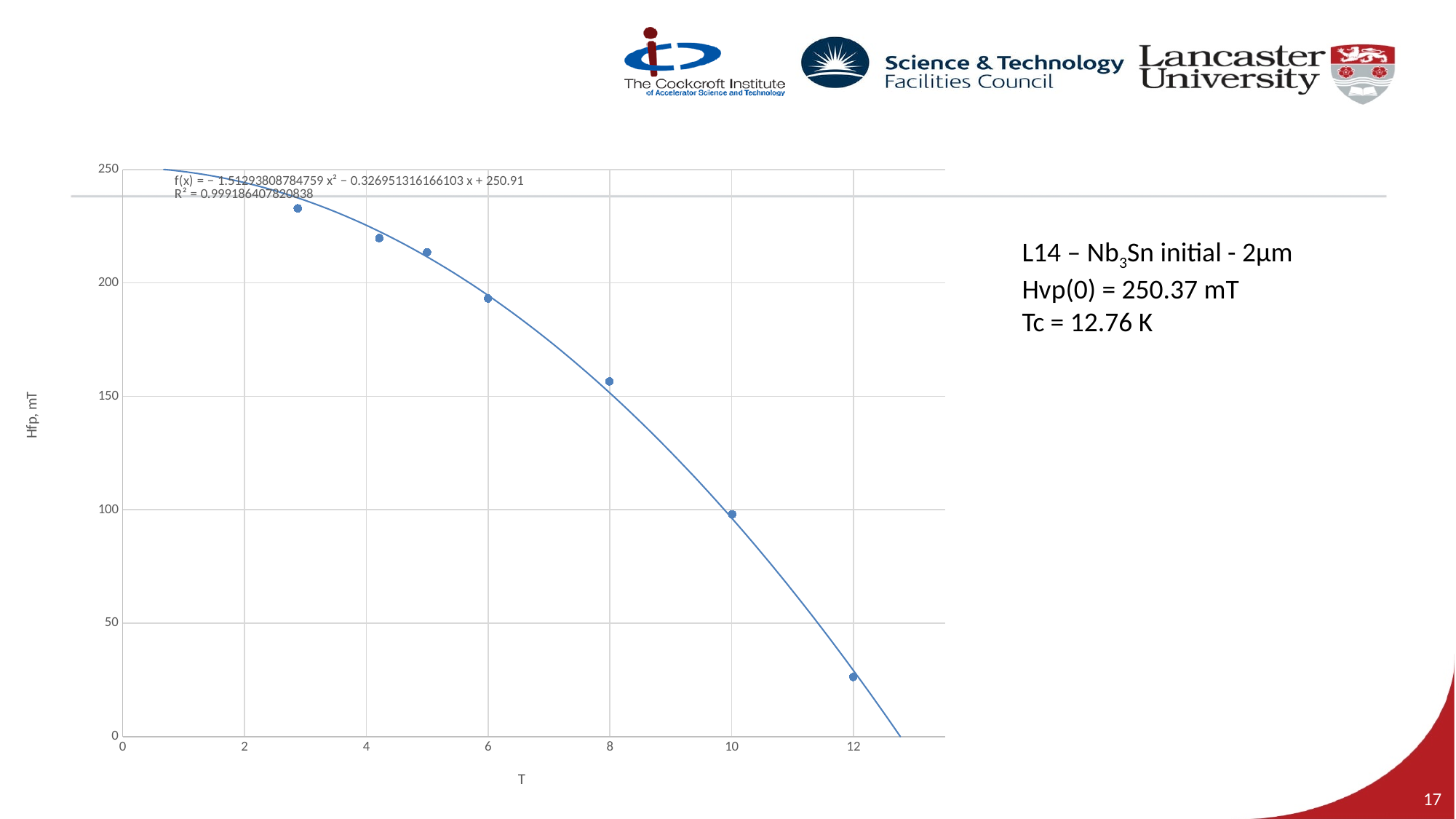
What kind of chart is shown on the slide? scatter chart Do the plotted values rise or fall as T increases along the x axis? fall What R² value is printed on the chart for the fitted curve? 0.999186407820838 Which is larger, the Hfp value at T = 8 or at T = 10? T = 8 Is the value for the point at T = 10 greater or less than 50? greater Is the value for the point at T = 6 greater or less than 200? less What is the label of the y axis? Hfp, mT Which plotted point has the lowest Hfp value? the point at T = 12 Is the value for the point at T = 12 greater or less than 50? less How many data points are plotted on the chart? 7